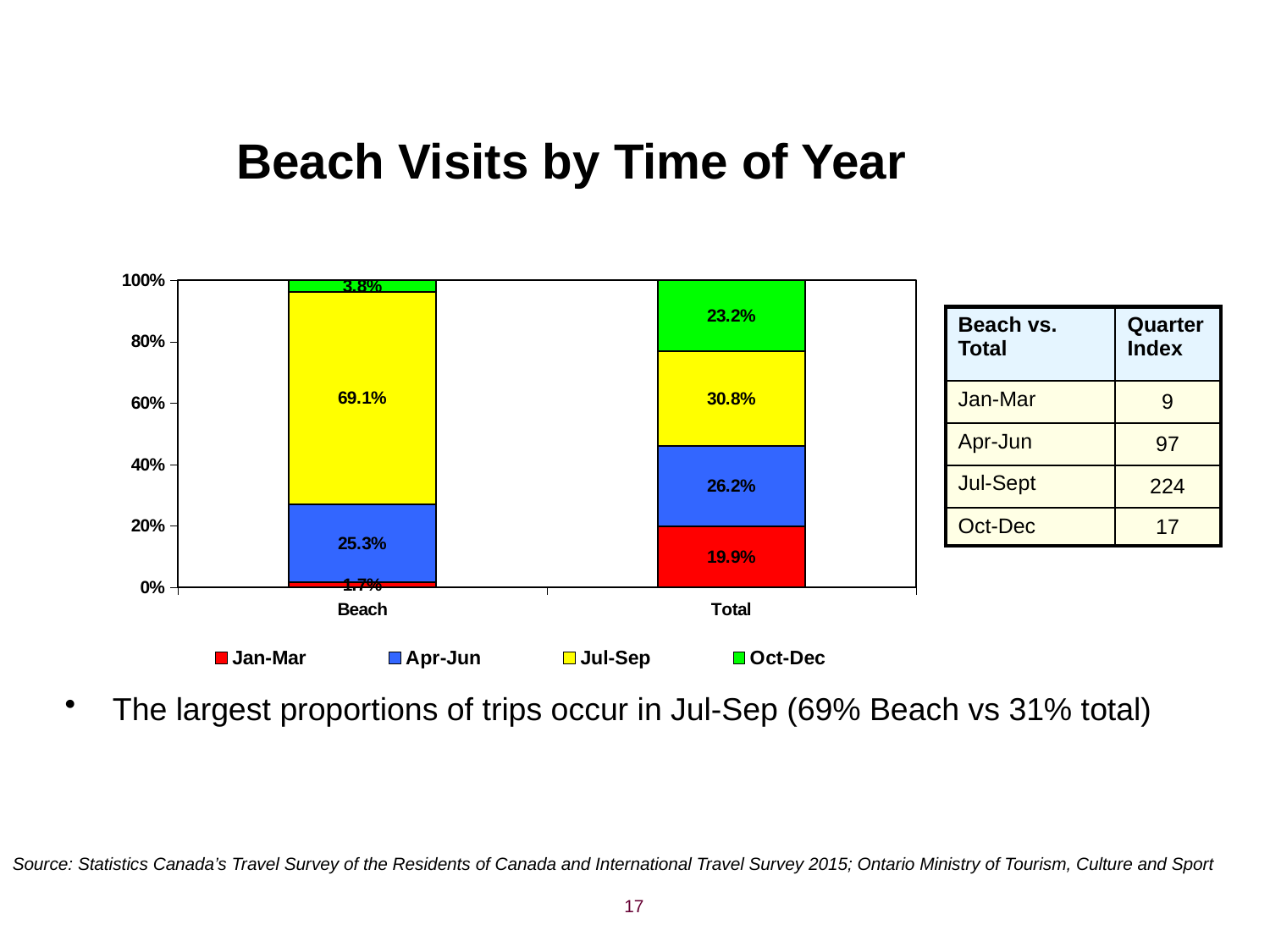
Which quarter has the smallest share of the Beach bar? Jan-Mar What kind of chart is shown on the slide? Stacked bar chart What is the Apr-Jun value for the Total bar? 26.2% Which quarter has the smallest share of the Total bar? Jan-Mar Which quarter has the largest share of the Beach bar? Jul-Sep How many series does the legend list? 4 What is the Jul-Sep value for the Beach bar? 69.1% How many bars are shown in the chart? 2 What is the Jan-Mar value for the Total bar? 19.9% What is the difference between the Jul-Sep values for Beach and Total? 38.3% What is the Oct-Dec value for the Beach bar? 3.8% Which is larger: the Oct-Dec value for Beach or the Oct-Dec value for Total? Total